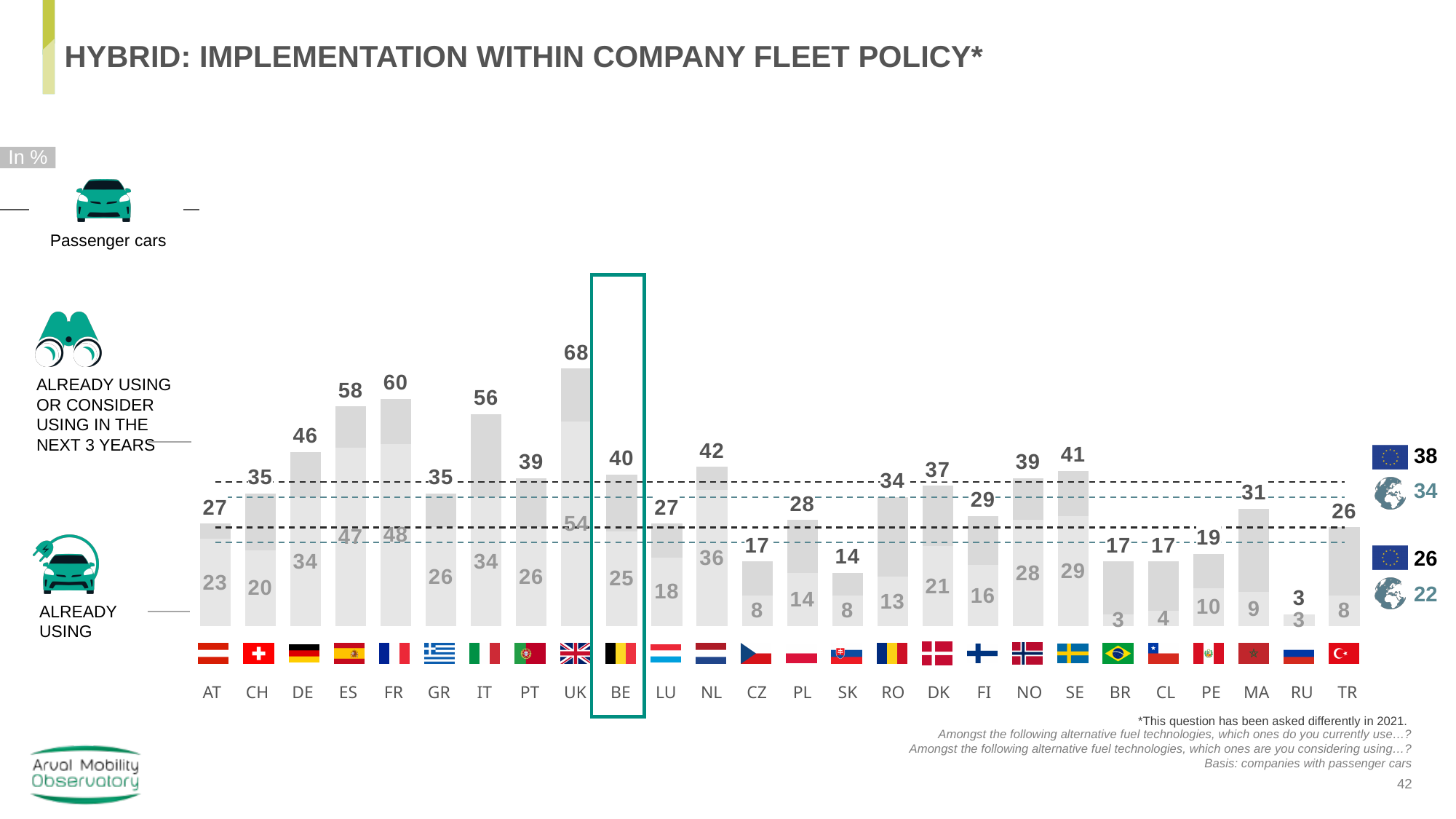
Which country is highlighted with a teal rectangle on the chart? BE How many countries are shown on the x axis of the chart? 26 What is the EU average for 'already using or consider using in the next 3 years' shown at the right of the chart? 38 What is the 'already using or consider using in the next 3 years' value for the UK? 68 What is the 'already using' value for Belgium (BE)? 25 What is the global average for 'already using' shown at the right of the chart? 22 Which has a higher 'already using' value, NL or DE? NL Which country has the highest 'already using or consider using in the next 3 years' value? UK What is the difference between the 'already using or consider using' values for FR and ES? 2 What kind of chart is shown on the slide? Bar chart What is the difference between the 'already using or consider using' value and the 'already using' value for the UK? 14 Which country has the lowest 'already using or consider using in the next 3 years' value? RU